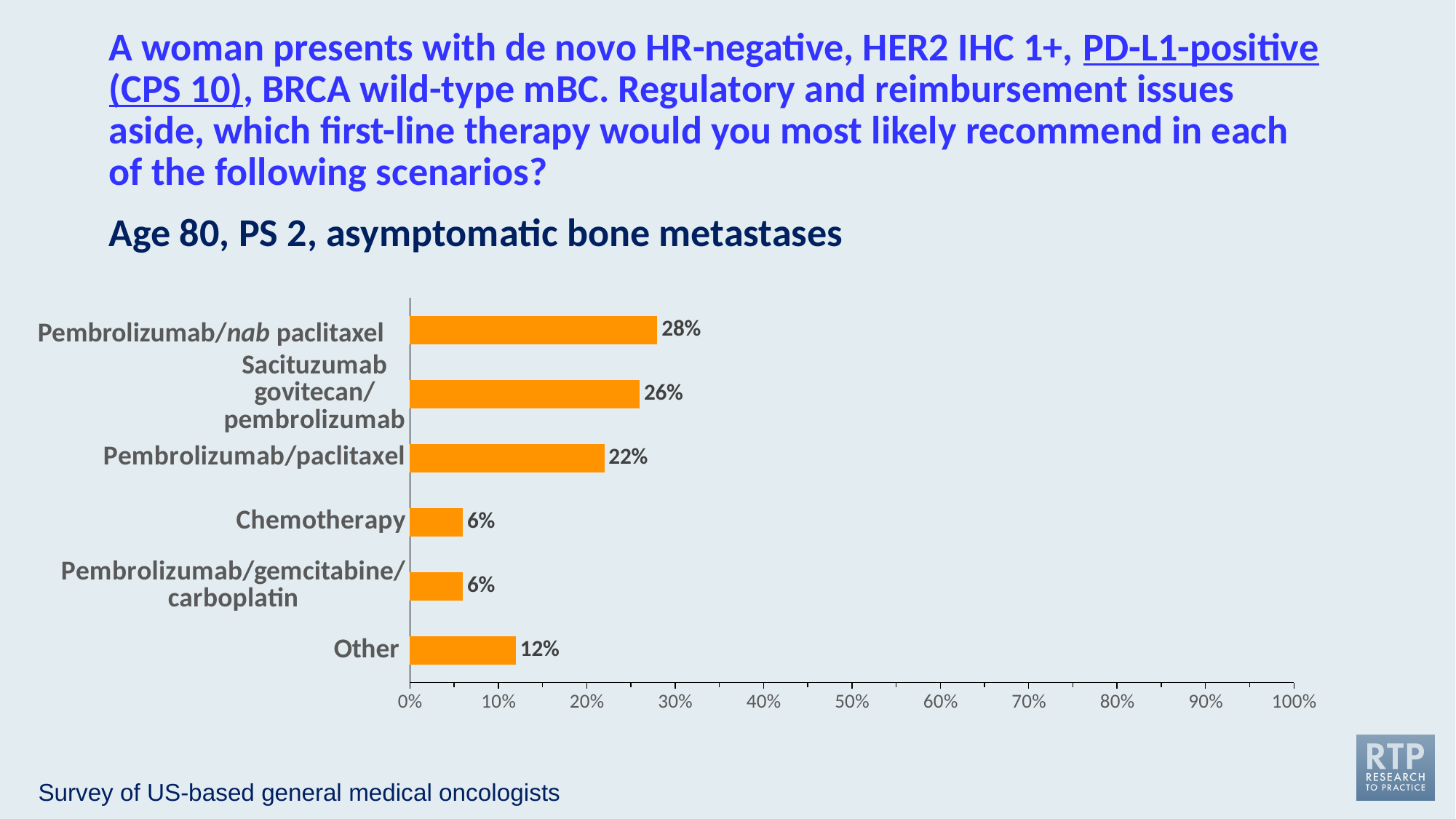
How many response options are shown on the chart? 6 What percentage of respondents chose Pembrolizumab/nab paclitaxel? 28% What is the maximum value shown on the x axis? 100% What percentage of respondents chose Pembrolizumab/paclitaxel? 22% What percentage of respondents chose Other? 12% What percentage of respondents chose Sacituzumab govitecan/pembrolizumab? 26% Which option received the highest percentage of responses? Pembrolizumab/nab paclitaxel Which received a larger share of responses, Other or Chemotherapy? Other What is the difference in percentage points between Pembrolizumab/nab paclitaxel and Pembrolizumab/paclitaxel? 6 What kind of chart is shown on the slide? Bar chart Is the value for Sacituzumab govitecan/pembrolizumab greater or less than 30%? less What is the combined percentage for Chemotherapy and Pembrolizumab/gemcitabine/carboplatin? 12%